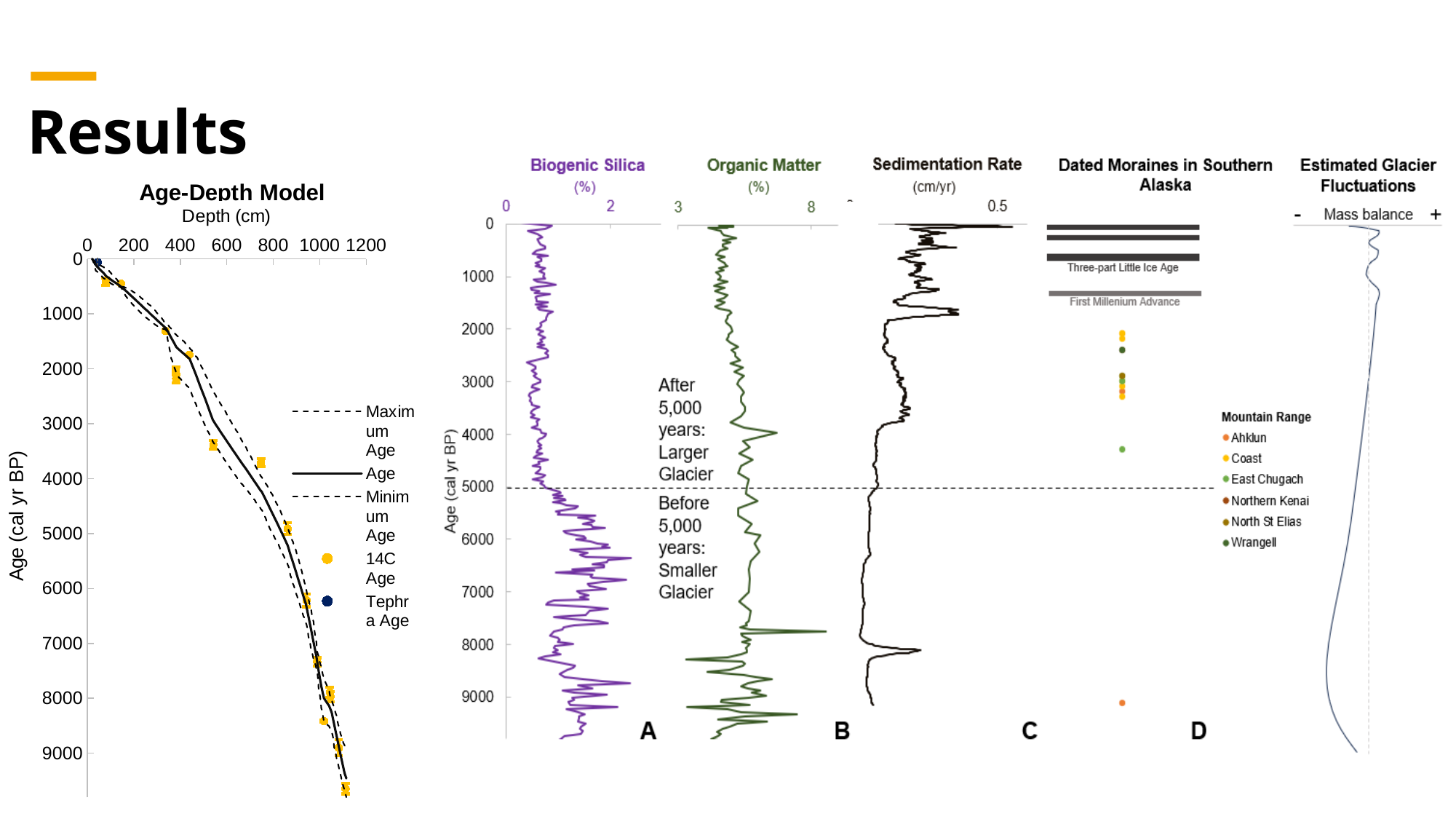
In the Age-Depth Model chart, what is the label of the horizontal axis? Depth (cm) In the Age-Depth Model chart, does the Age curve increase or decrease as depth increases? increase In the right-hand figure, which mountain range has the dated moraine plotted near 9000 cal yr BP? Ahklun In the right-hand figure, which panel letter is labelled Sedimentation Rate? C In the Age-Depth Model chart, what is the largest tick value shown on the Depth axis? 1200 In the right-hand figure, at what age (cal yr BP) is the horizontal dashed line drawn? 5000 What kind of chart is the Age-Depth Model? line chart In the Age-Depth Model chart, how many series does the legend list? 5 In the Age-Depth Model chart, what is the largest tick value shown on the Age (cal yr BP) axis? 9000 In the right-hand figure, how many mountain ranges are listed in the Mountain Range legend? 6 In the right-hand figure, what is the maximum tick value on the Sedimentation Rate axis? 0.5 In the right-hand figure, what is the maximum tick value on the Biogenic Silica (%) axis? 2